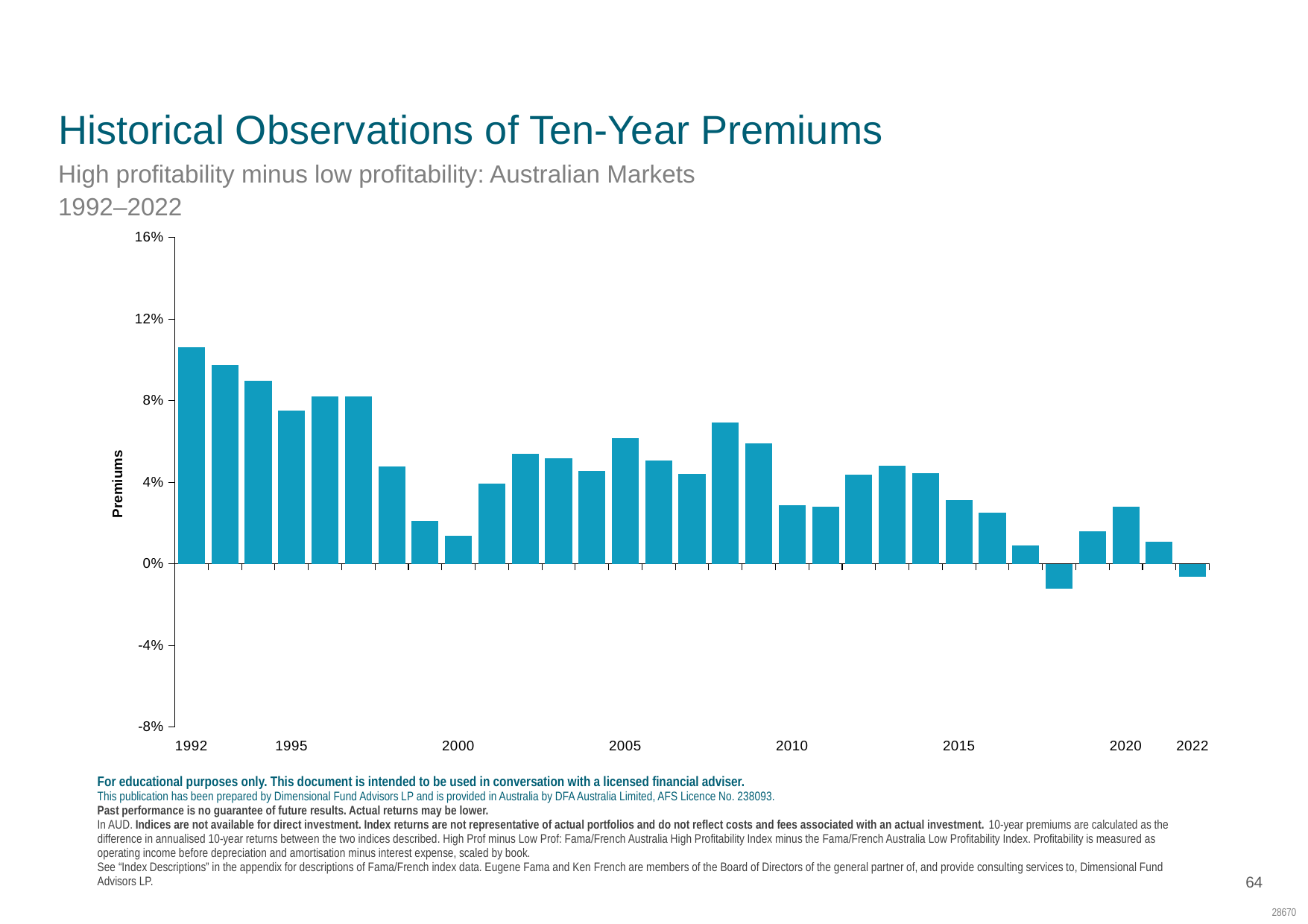
What is the label on the vertical axis of the chart? Premiums Overall, do the premiums rise or fall from 1992 to 2022? Fall Is the value for 2008 greater or less than 8%? less Is the value for 2018 greater or less than 0%? less What kind of chart is shown on the slide? Bar chart Is the value for 1992 greater or less than 8%? greater Which year has the larger premium, 2008 or 2010? 2008 How many years (bars) are plotted in the chart? 31 Which year has the lowest ten-year premium in the chart? 2018 Which year has the larger premium, 1992 or 2022? 1992 Which year has the highest ten-year premium in the chart? 1992